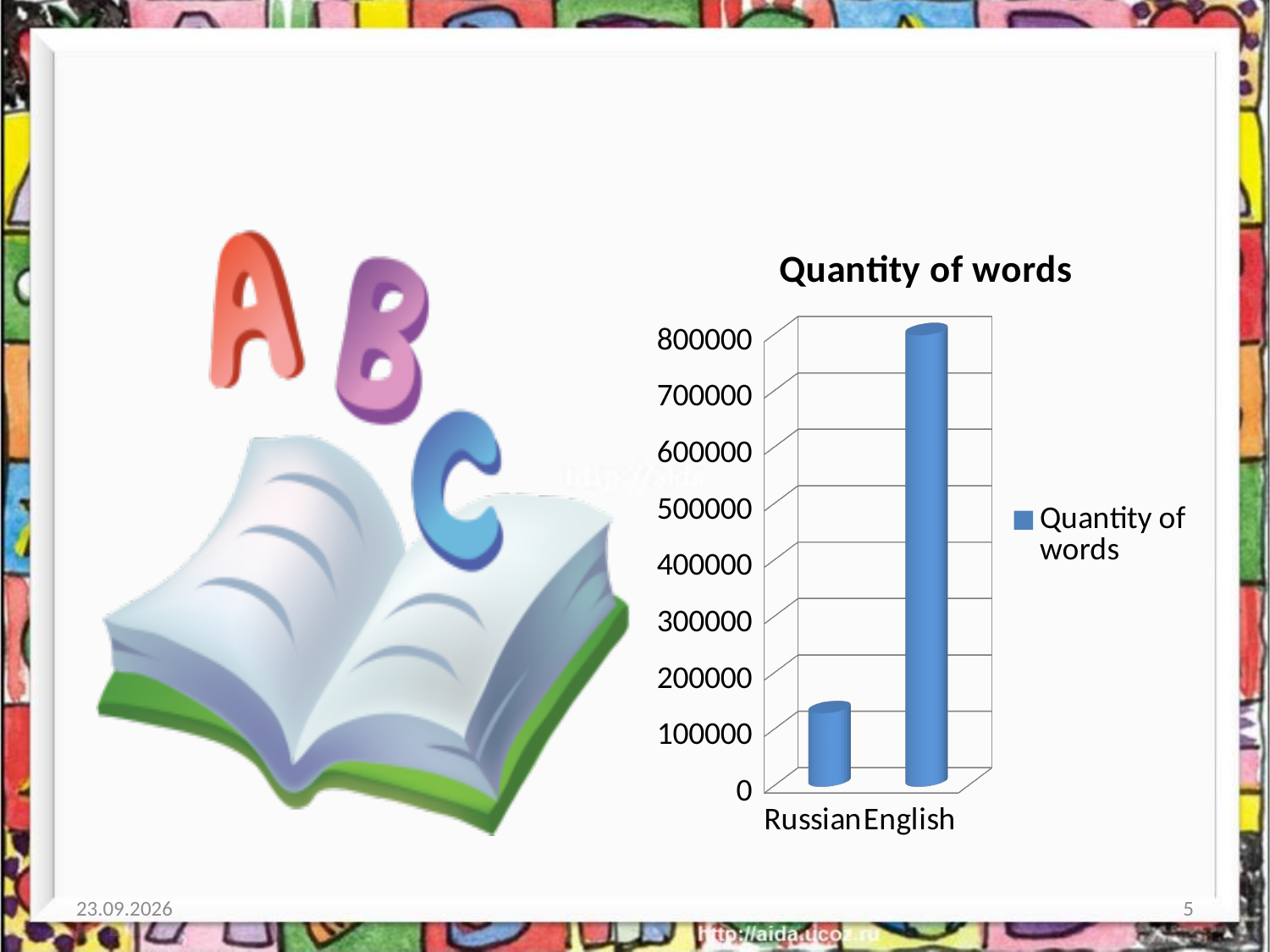
What is the name of the series in the legend? Quantity of words How many categories are shown on the x axis of the chart? 2 Is the value for Russian greater or less than 200000? less How many series does the legend list? 1 What kind of chart is shown on the slide? bar chart What is the title of the chart? Quantity of words Do the values rise or fall from Russian to English along the x axis? rise Is the value for English greater or less than 500000? greater Which has a larger quantity of words, Russian or English? English Which category has the lowest quantity of words? Russian Which category has the highest quantity of words? English Is the value for English greater or less than 700000? greater